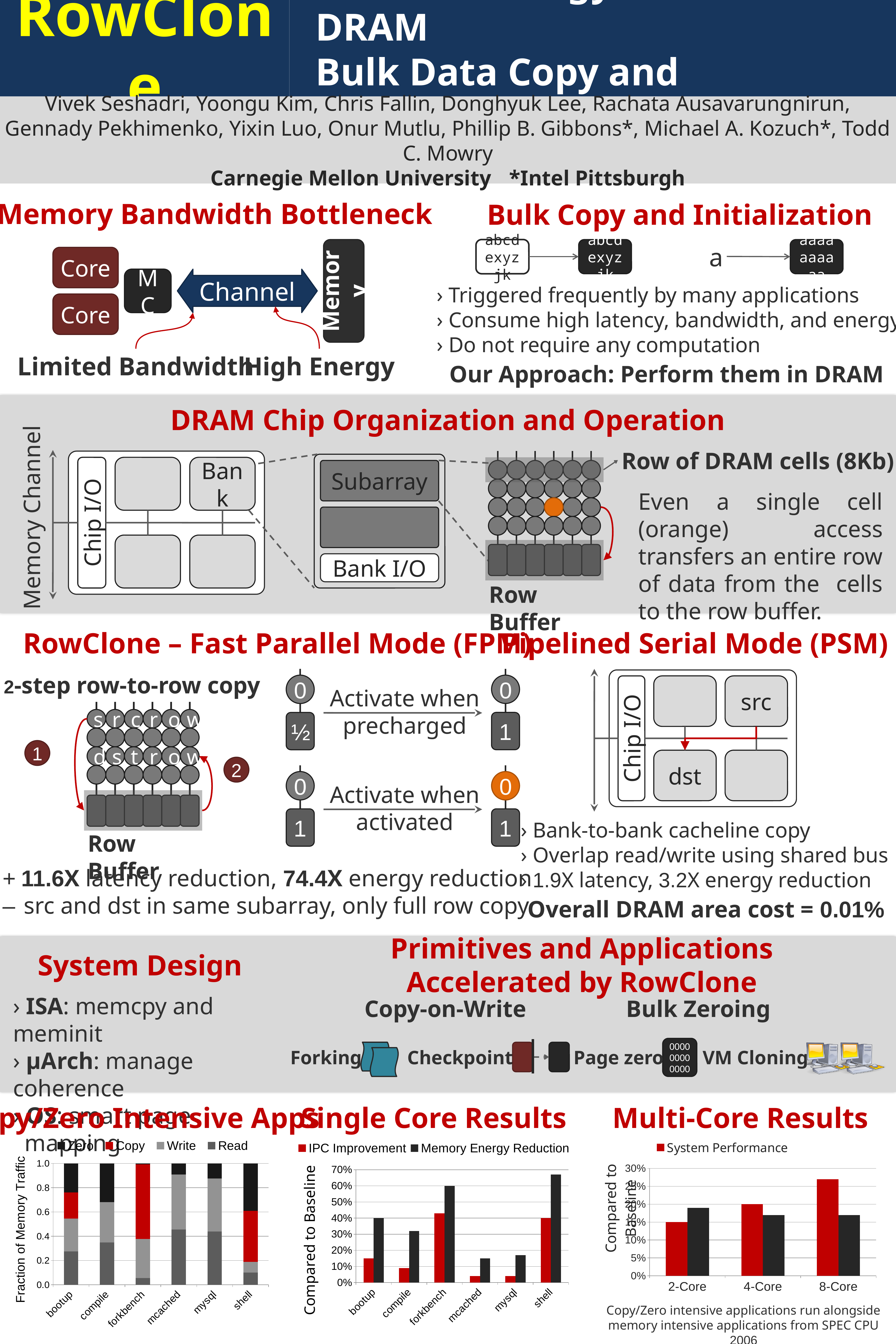
In the Single Core Results chart, which is larger for compile: IPC Improvement or Memory Energy Reduction? Memory Energy Reduction In the Single Core Results chart, what type of chart is shown? bar chart In the Single Core Results chart, which application has the highest Memory Energy Reduction? shell In the Single Core Results chart, is the Memory Energy Reduction for mcached greater or less than 20%? less In the Single Core Results chart, how many applications are shown on the x axis? 6 In the Single Core Results chart, is the IPC Improvement for forkbench greater or less than 40%? greater In the Single Core Results chart, how many series does the legend list? 2 In the Multi-Core Results chart, does the System Performance value rise or fall as the core count increases from 2-Core to 8-Core? rise In the Copy/Zero Intensive Apps chart, which application has the largest Copy fraction of memory traffic? forkbench In the Copy/Zero Intensive Apps chart, how many series does the legend list? 4 In the Multi-Core Results chart, is the System Performance for 8-Core greater or less than 25%? greater In the Multi-Core Results chart, how many core configurations are shown on the x axis? 3